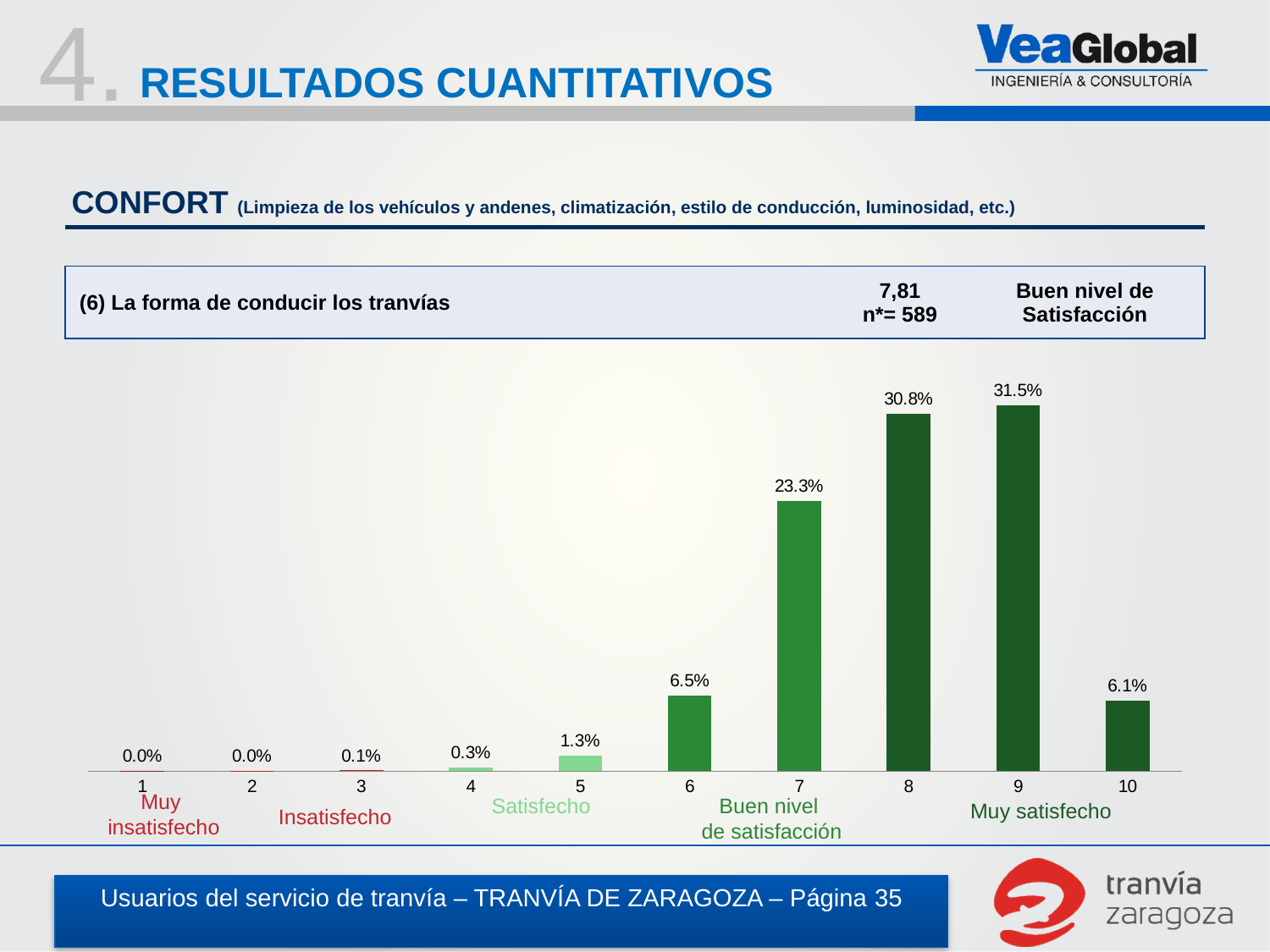
What kind of chart is shown on the slide? Bar chart What is the difference in percentage points between score 9 and score 8? 0.7 Which has a larger percentage, score 6 or score 10? Score 6 Which score has the highest percentage of respondents? 9 What percentage of respondents gave a score of 7? 23.3% What percentage of respondents gave a score of 9 for 'La forma de conducir los tranvías'? 31.5% What is the average score (mean) shown in the box for 'La forma de conducir los tranvías'? 7,81 How many score categories are shown on the x axis? 10 What percentage of respondents gave a score of 5? 1.3% Do the percentages rise or fall from score 1 to score 9? Rise What is the difference in percentage points between score 8 and score 7? 7.5 What percentage of respondents gave a score of 10? 6.1%